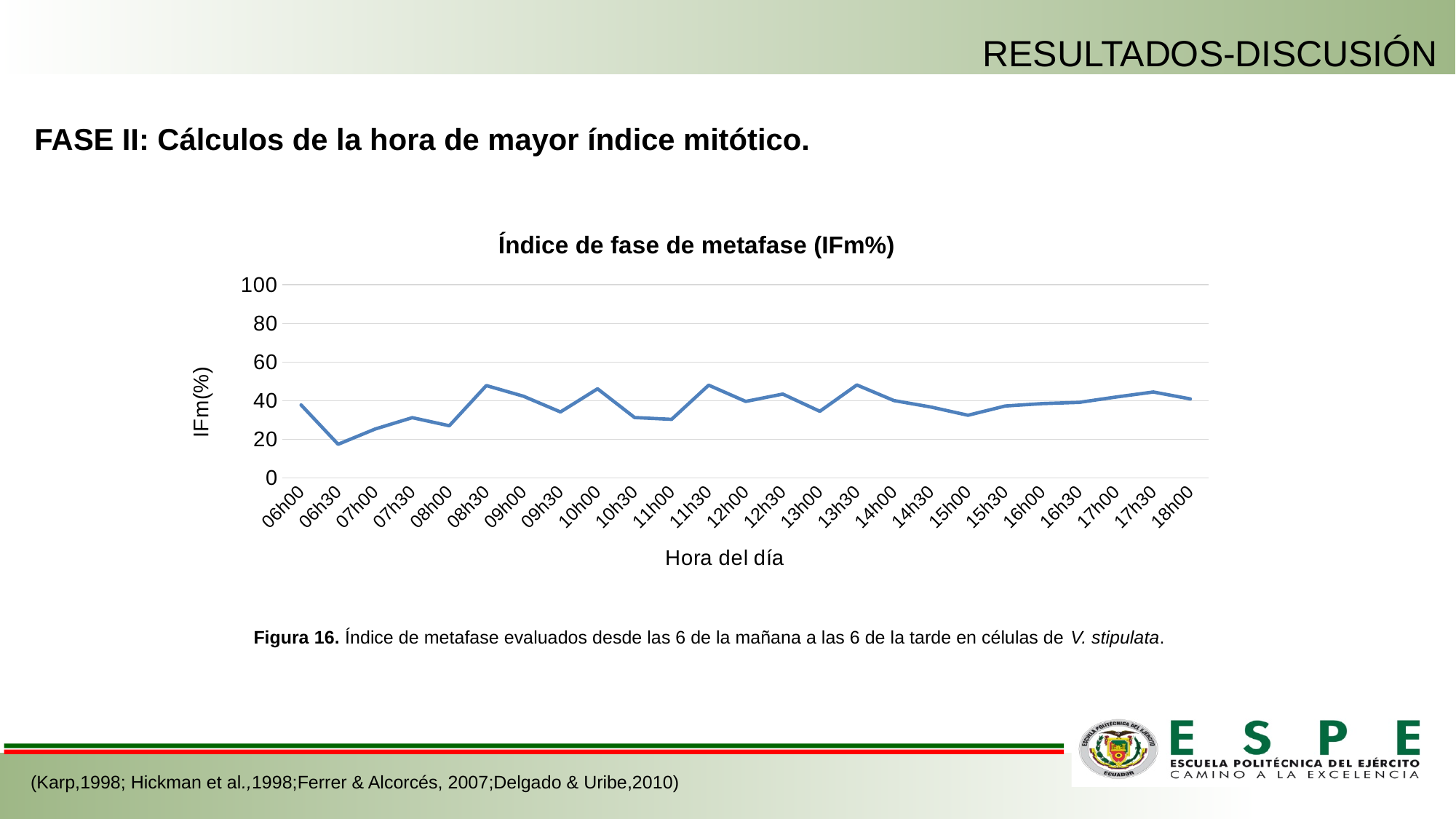
How many time points are plotted along the x axis? 25 Does the IFm(%) value rise or fall between 06h00 and 06h30? fall Which has the larger IFm(%) value, 13h30 or 15h00? 13h30 Is the value for 15h00 greater or less than 40? less What is the label of the x axis of the chart? Hora del día What kind of chart is shown on the slide? line chart Is the value for 06h30 greater or less than 40? less At which hour of the day is the IFm(%) value lowest? 06h30 Which has the larger IFm(%) value, 08h30 or 06h30? 08h30 What is the title of the chart? Índice de fase de metafase (IFm%) Is the value for 13h30 greater or less than 60? less